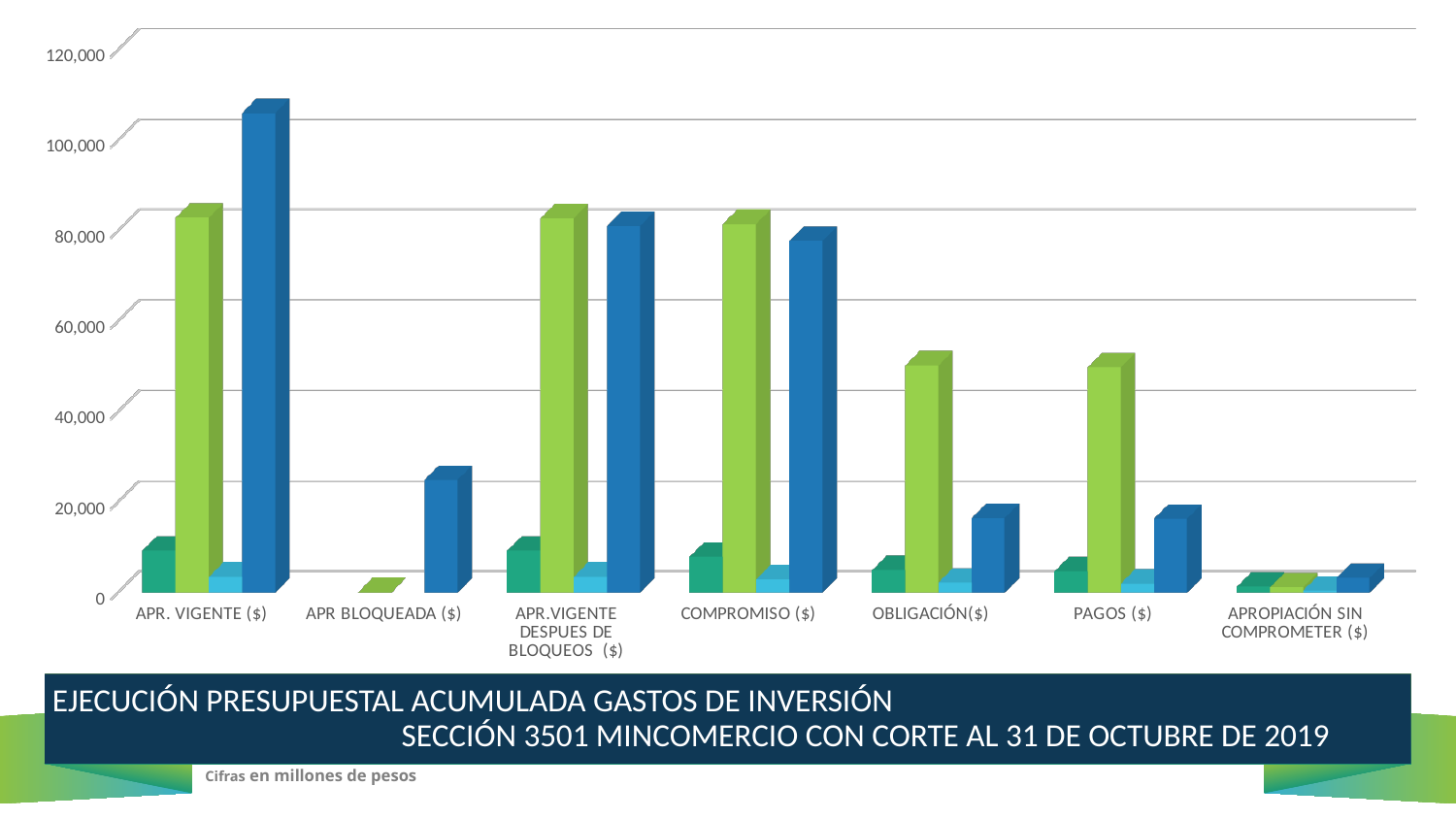
Which is larger: the dark blue bar for APR. VIGENTE ($) or the dark blue bar for COMPROMISO ($)? APR. VIGENTE ($) Is the dark blue bar for APR. VIGENTE ($) greater or less than 100,000? greater Is the dark blue bar for APR BLOQUEADA ($) greater or less than 20,000? greater Which category has the smallest bars overall in the chart? APROPIACIÓN SIN COMPROMETER ($) Which category has the tallest bar in the chart? APR. VIGENTE ($) Which is larger: the light green bar for OBLIGACIÓN($) or the light green bar for COMPROMISO ($)? COMPROMISO ($) According to the note below the chart, in what units are the figures expressed? millones de pesos Is the dark blue bar for PAGOS ($) greater or less than 20,000? less What kind of chart is shown on the slide? bar chart How many categories are shown along the x axis of the chart? 7